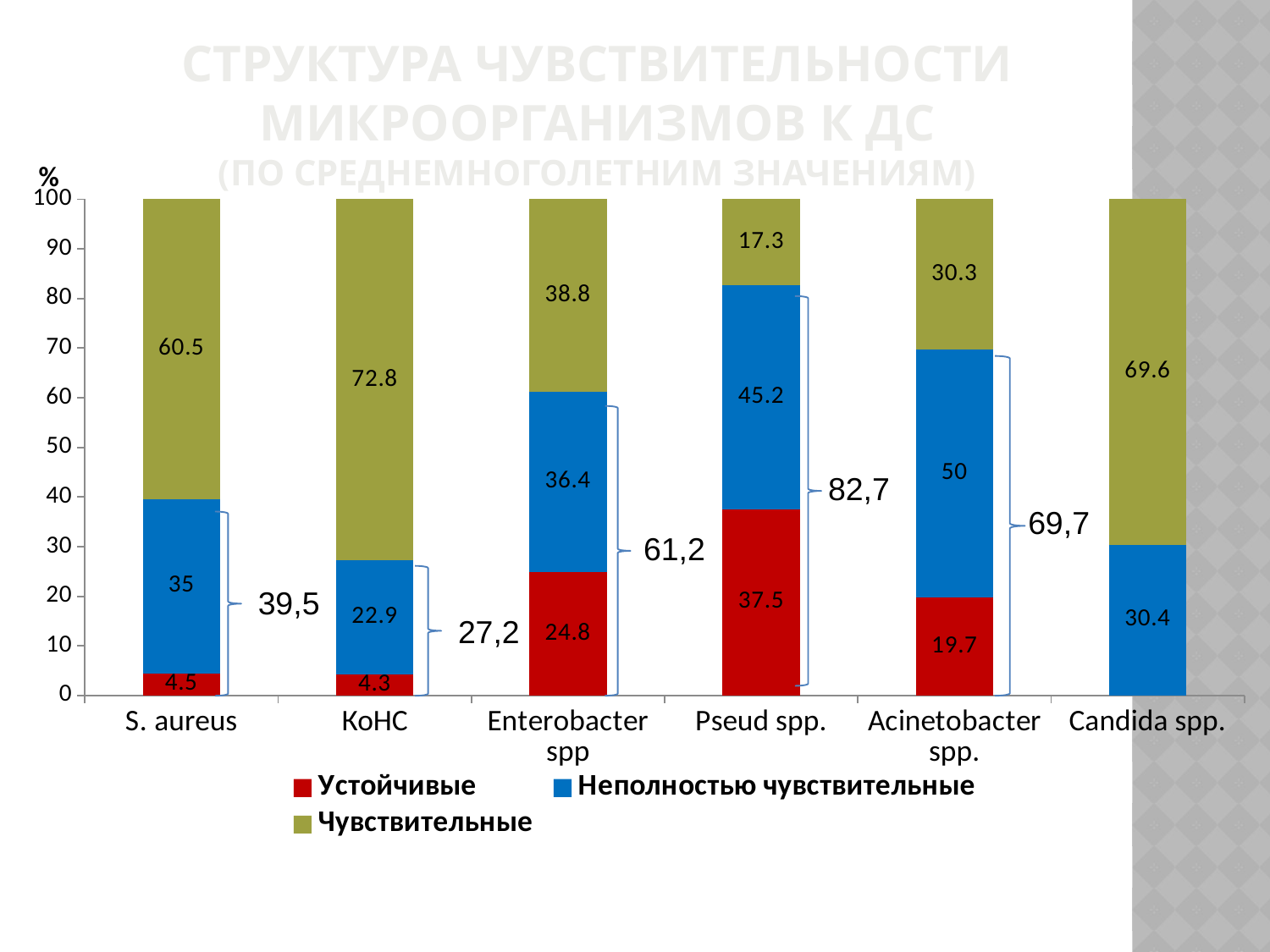
What value is shown by the bracket annotation beside the Pseud spp. bar? 82,7 What is the value of Устойчивые for Pseud spp.? 37.5 How many series does the legend list? 3 Which category has the lowest value for Чувствительные? Pseud spp. Which category has the highest value for Устойчивые? Pseud spp. What is the difference between the Неполностью чувствительные values for Acinetobacter spp. and Enterobacter spp? 13.6 What is the total of the stacked bar for Enterobacter spp? 100 Which has the larger Чувствительные value, S. aureus or Candida spp.? Candida spp. How many categories are shown on the x axis? 6 What kind of chart is shown on the slide? Stacked bar chart What is the value of Неполностью чувствительные for Acinetobacter spp.? 50 What is the value of Чувствительные for КоНС? 72.8